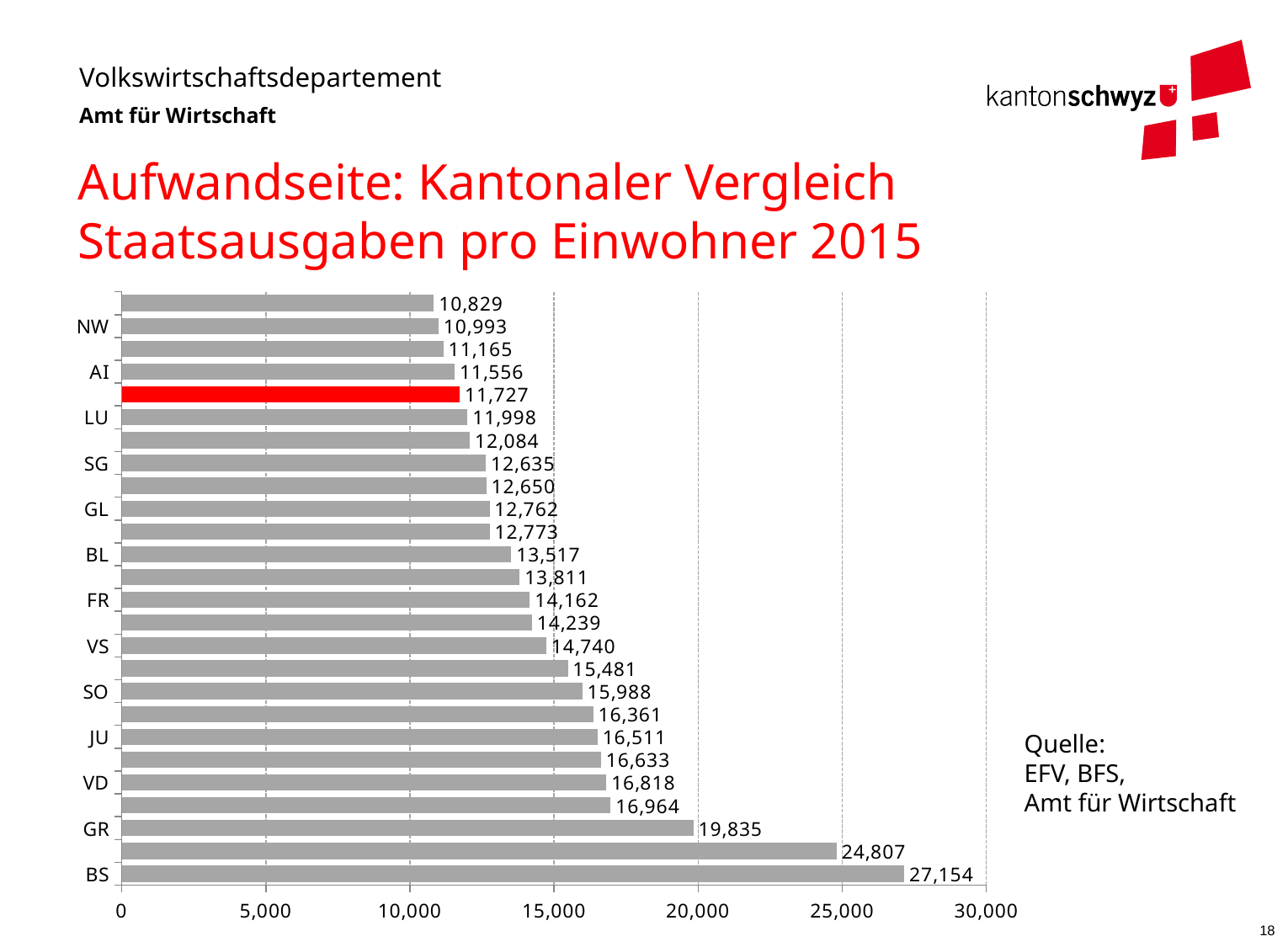
What is the value for BS? 27,154 Is the value for SO greater or less than 15,000? greater What is the value of the shortest bar in the chart? 10,829 Which labelled canton has the highest value? BS What is the value for GR? 19,835 What type of chart is shown on the slide? bar chart What is the value for NW? 10,993 What is the value of the bar highlighted in red? 11,727 What is the difference between the values for BS and GR? 7,319 Which has a larger value, VD or JU? VD What is the value for LU? 11,998 What is the value for VS? 14,740